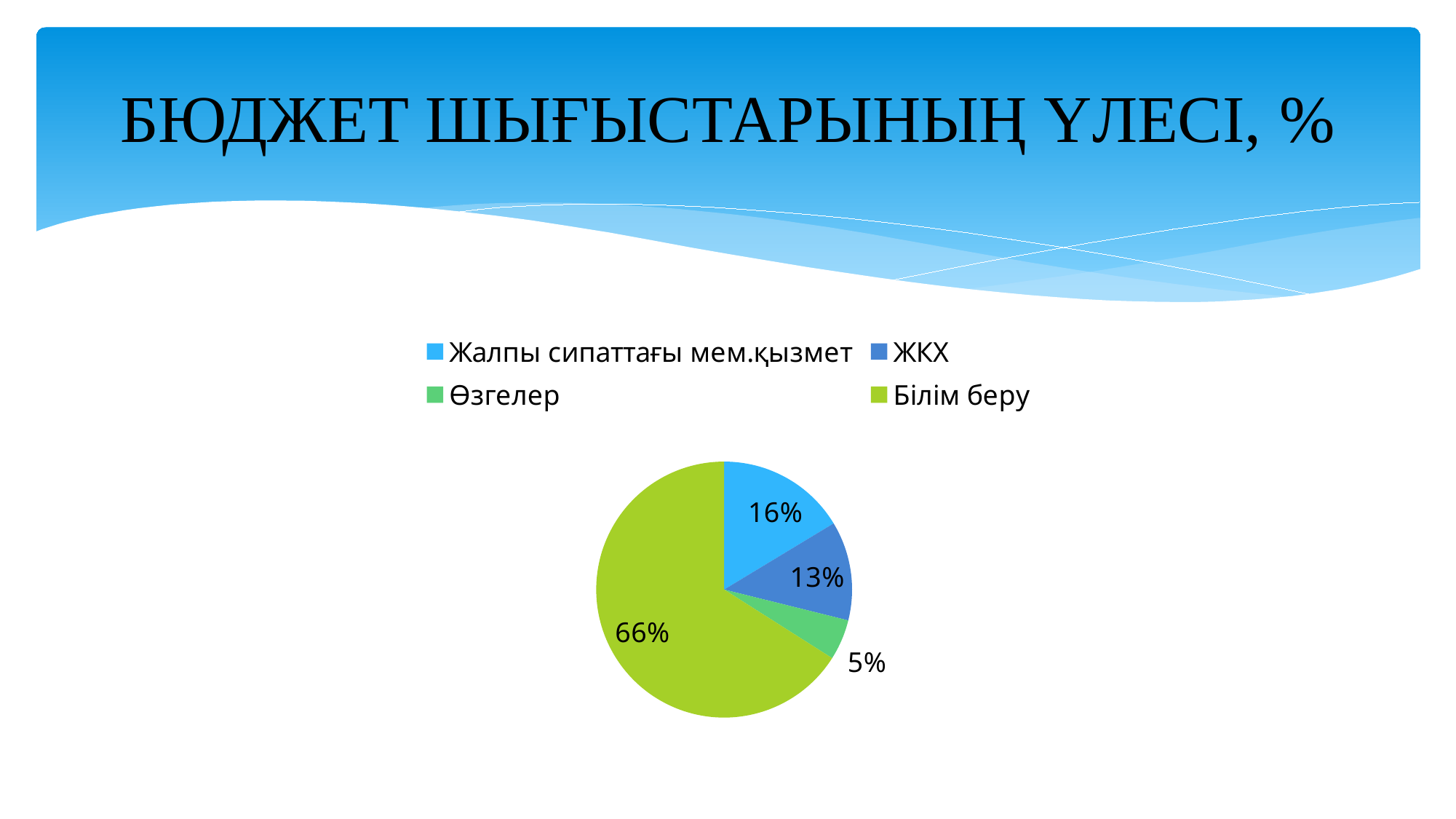
What share of the pie does ЖКХ have? 13% Which category has the smallest slice of the pie? Өзгелер Which category has the largest slice of the pie? Білім беру What colour is the slice for Білім беру? green (yellow-green) What share of the pie does Жалпы сипаттағы мем.қызмет have? 16% Which is larger, the share of ЖКХ or the share of Өзгелер? ЖКХ How many categories does the pie chart have? 4 What share of the pie does Білім беру have? 66% How many entries does the legend list? 4 What is the difference between the shares of Білім беру and Жалпы сипаттағы мем.қызмет? 50% What kind of chart is shown on the slide? pie chart What share of the pie does Өзгелер have? 5%